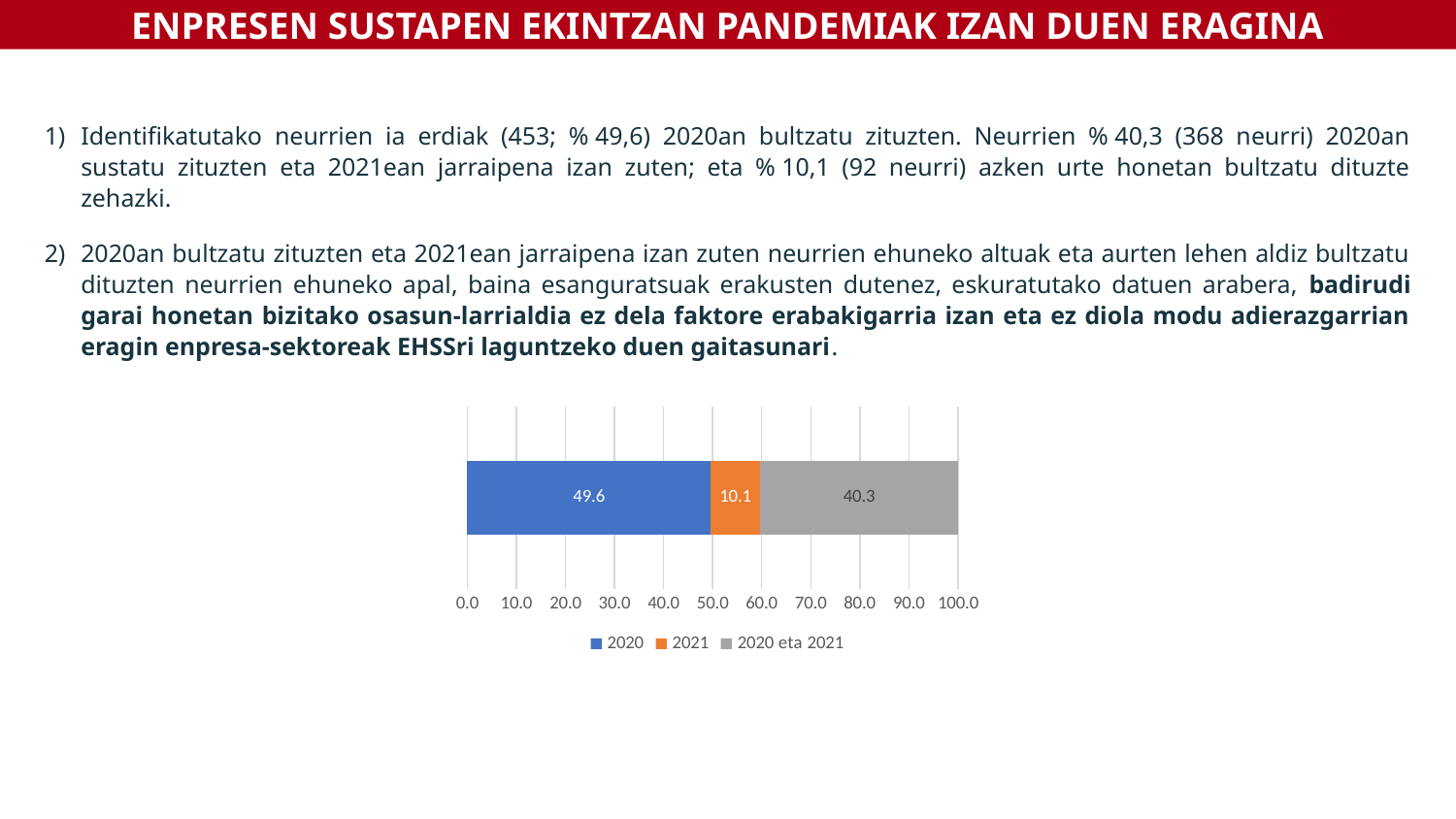
What is the value for the '2020 eta 2021' series in the chart? 40.3 Which is larger, the value for 2021 or the value for '2020 eta 2021'? 2020 eta 2021 Which series has the largest value in the chart? 2020 What colour is the 2021 segment in the chart? Orange What is the value for the 2021 series in the chart? 10.1 What is the total of the stacked bar in the chart? 100.0 What kind of chart is shown on the slide? Stacked bar chart Which series has the smallest value in the chart? 2021 How many series does the chart legend list? 3 What is the value for the 2020 series in the chart? 49.6 What is the difference between the '2020 eta 2021' value and the 2021 value? 30.2 What is the difference between the 2020 value and the '2020 eta 2021' value? 9.3